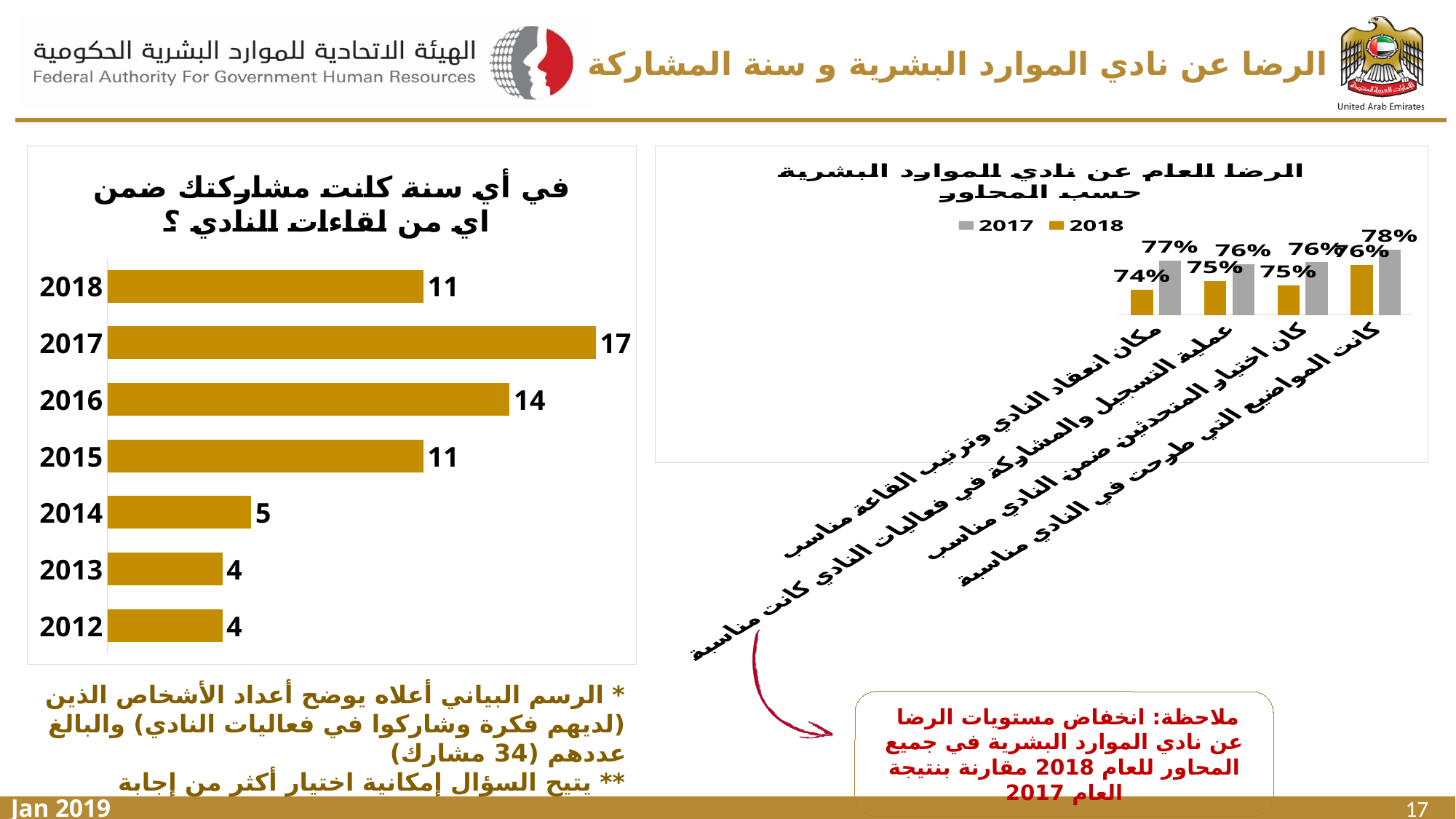
In the right chart (الرضا العام عن نادي الموارد البشرية حسب المحاور), what is the difference between the 2017 and 2018 values for the first category (مكان انعقاد النادي وترتيب القاعة مناسب)? 3% In the right chart (الرضا العام عن نادي الموارد البشرية حسب المحاور), what is the 2018 value for the first category (مكان انعقاد النادي وترتيب القاعة مناسب)? 74% In the right chart (الرضا العام عن نادي الموارد البشرية حسب المحاور), what is the 2017 value for the last category (كانت المواضيع التي طرحت في النادي مناسبة)? 78% What kind of chart is the left chart (participation by year)? Bar chart In the left chart (participation by year), what is the value for 2016? 14 In the left chart (participation by year), what is the value for 2017? 17 In the right chart (الرضا العام عن نادي الموارد البشرية حسب المحاور), which colour represents the 2018 series? Gold In the left chart (participation by year), what is the difference between the values for 2017 and 2018? 6 In the left chart (participation by year), which year has the highest value? 2017 In the right chart (الرضا العام عن نادي الموارد البشرية حسب المحاور), how many series does the legend list? 2 In the left chart (participation by year), which is larger, the value for 2015 or the value for 2014? 2015 In the left chart (participation by year), how many years are shown? 7